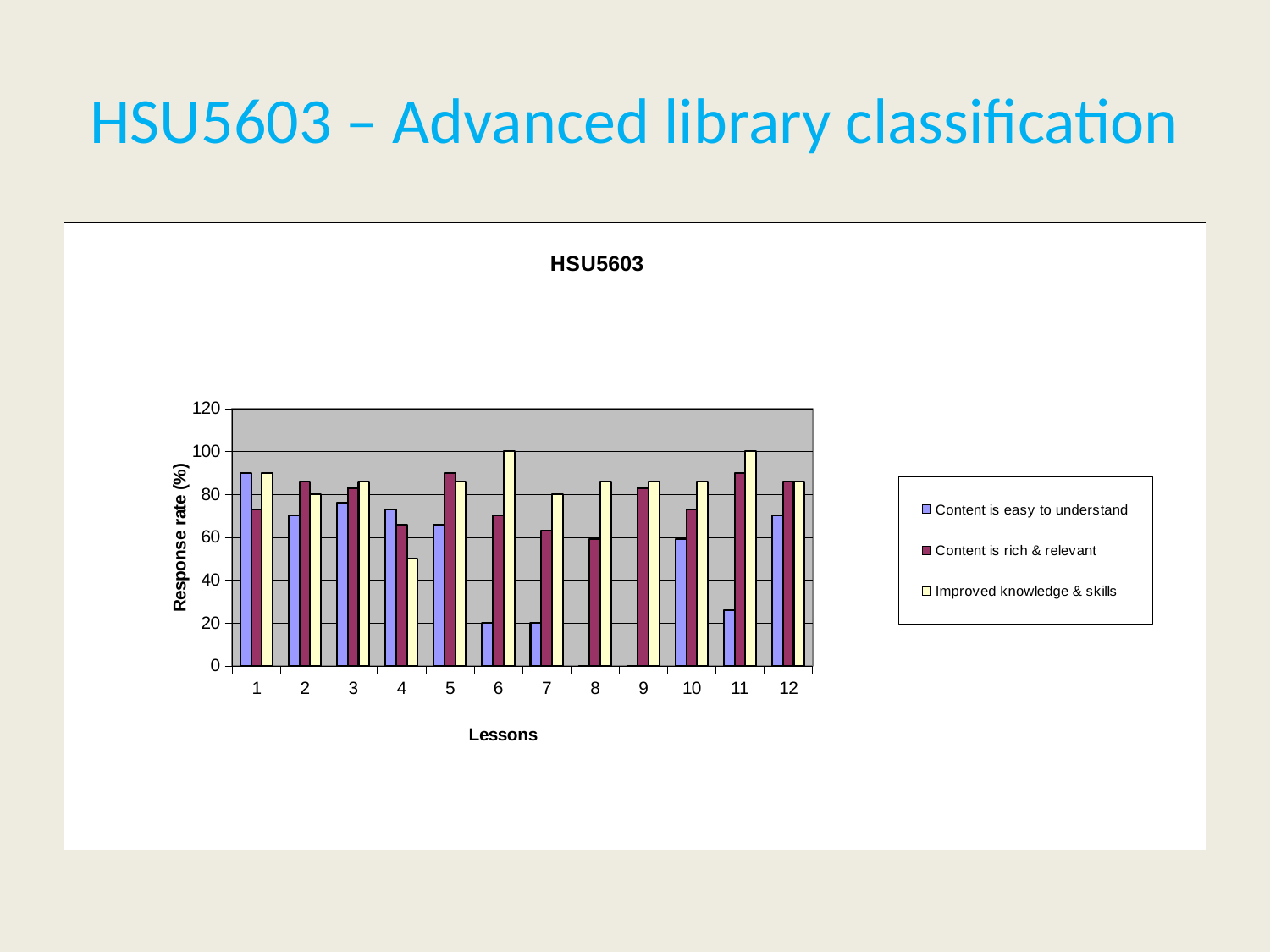
Which is larger, 'Content is rich & relevant' at lesson 4 or at lesson 5? lesson 5 What is the value for 'Content is easy to understand' at lesson 6? 20 Is the value for 'Content is easy to understand' at lesson 11 greater or less than 40? less How many series does the legend list? 3 Is the value for 'Content is easy to understand' at lesson 1 greater or less than 80? greater Is the value for 'Improved knowledge & skills' at lesson 4 greater or less than 60? less What is the title of the chart? HSU5603 How many lessons are shown along the x axis? 12 What is the value for 'Improved knowledge & skills' at lesson 6? 100 What is the label of the vertical axis? Response rate (%) Which lesson has the lowest value for 'Improved knowledge & skills'? 4 What kind of chart is shown on the slide? bar chart